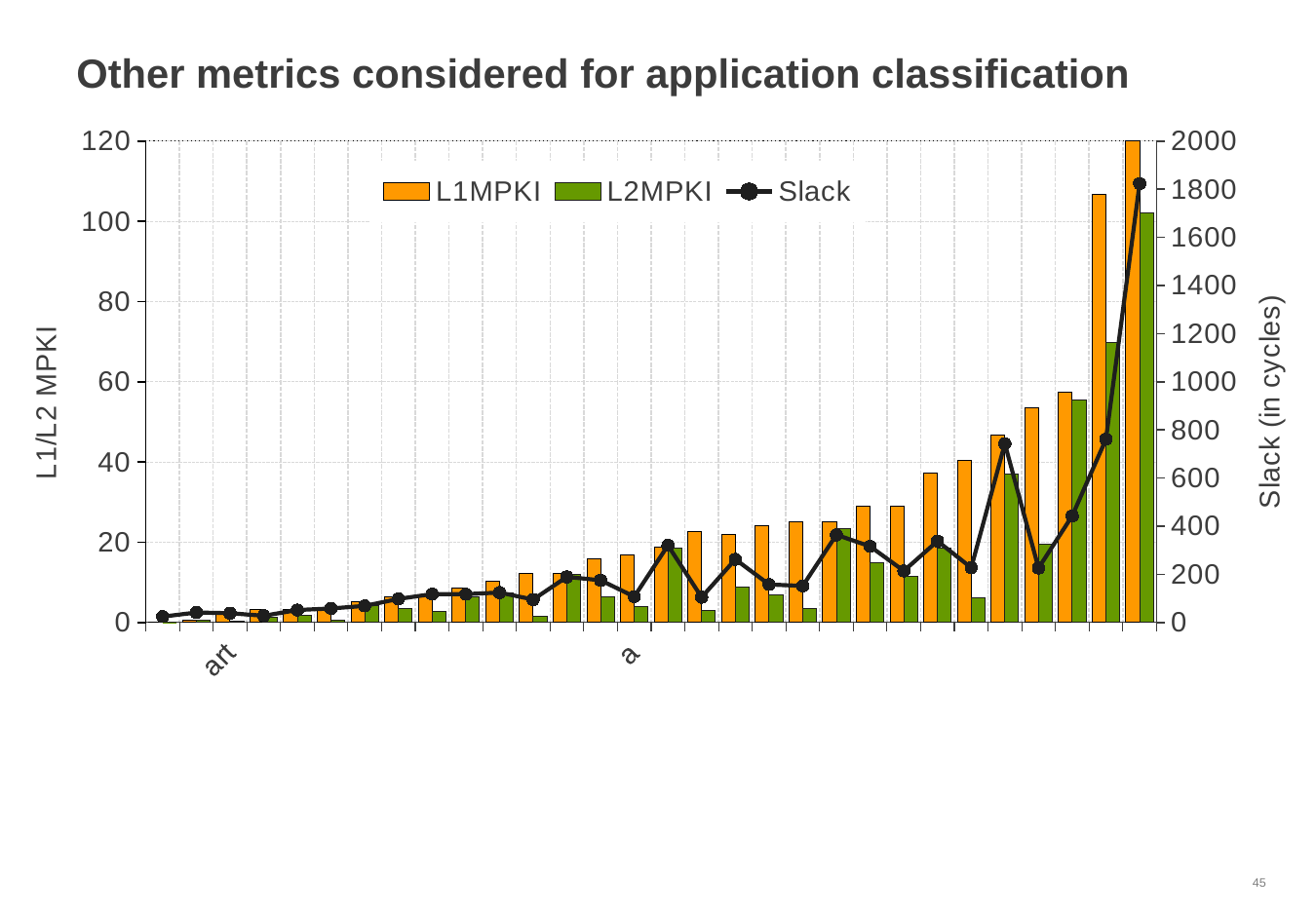
How many series does the legend list? 3 Is the L1MPKI value for a greater or less than 40? less What is the title of the right-hand vertical axis? Slack (in cycles) Which series is plotted as a line with markers? Slack Is the Slack value for art greater or less than 200? less Is the Slack value for a greater or less than 400? less Do the L1MPKI bars generally rise or fall from left to right along the x axis? Rise Which is larger for the category a, the L1MPKI bar or the L2MPKI bar? L1MPKI What is the maximum value shown on the left vertical axis? 120 What kind of chart is shown on the slide? A combined bar and line chart